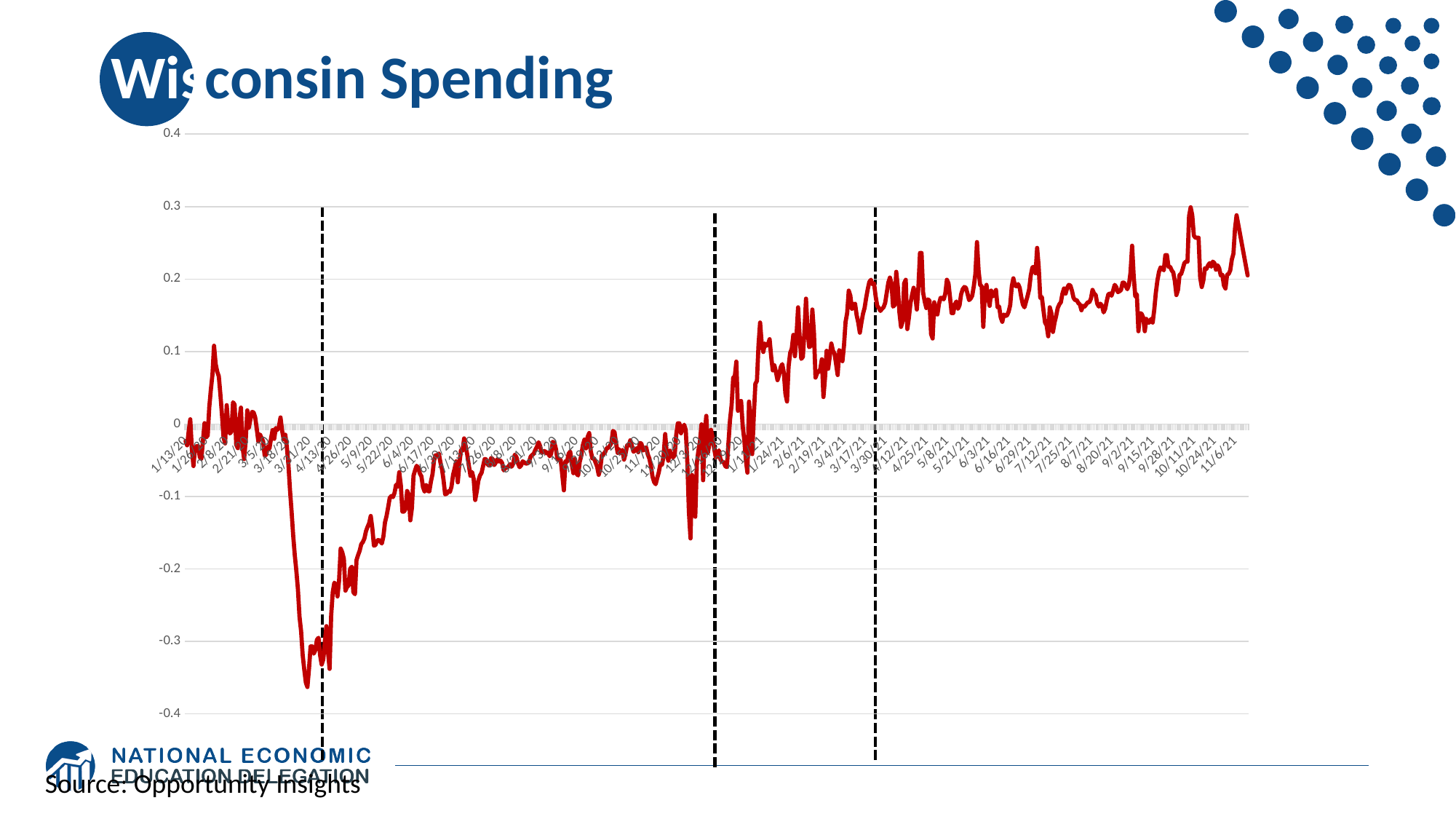
What is the title of the chart? Wisconsin Spending Is the value at 11/6/21 greater or less than 0.1? greater Is the lowest value reached by the line greater or less than -0.3? less Is the highest value reached by the line greater or less than 0.2? greater Does the line generally rise or fall from 4/13/20 to 11/6/21? rise What is the highest value shown on the vertical axis? 0.4 How many data lines are plotted on the chart? 1 What kind of chart is shown on the Wisconsin Spending slide? line chart What source is cited for the chart? Opportunity Insights Which is larger, the value at 4/13/20 or the value at 10/11/21? 10/11/21